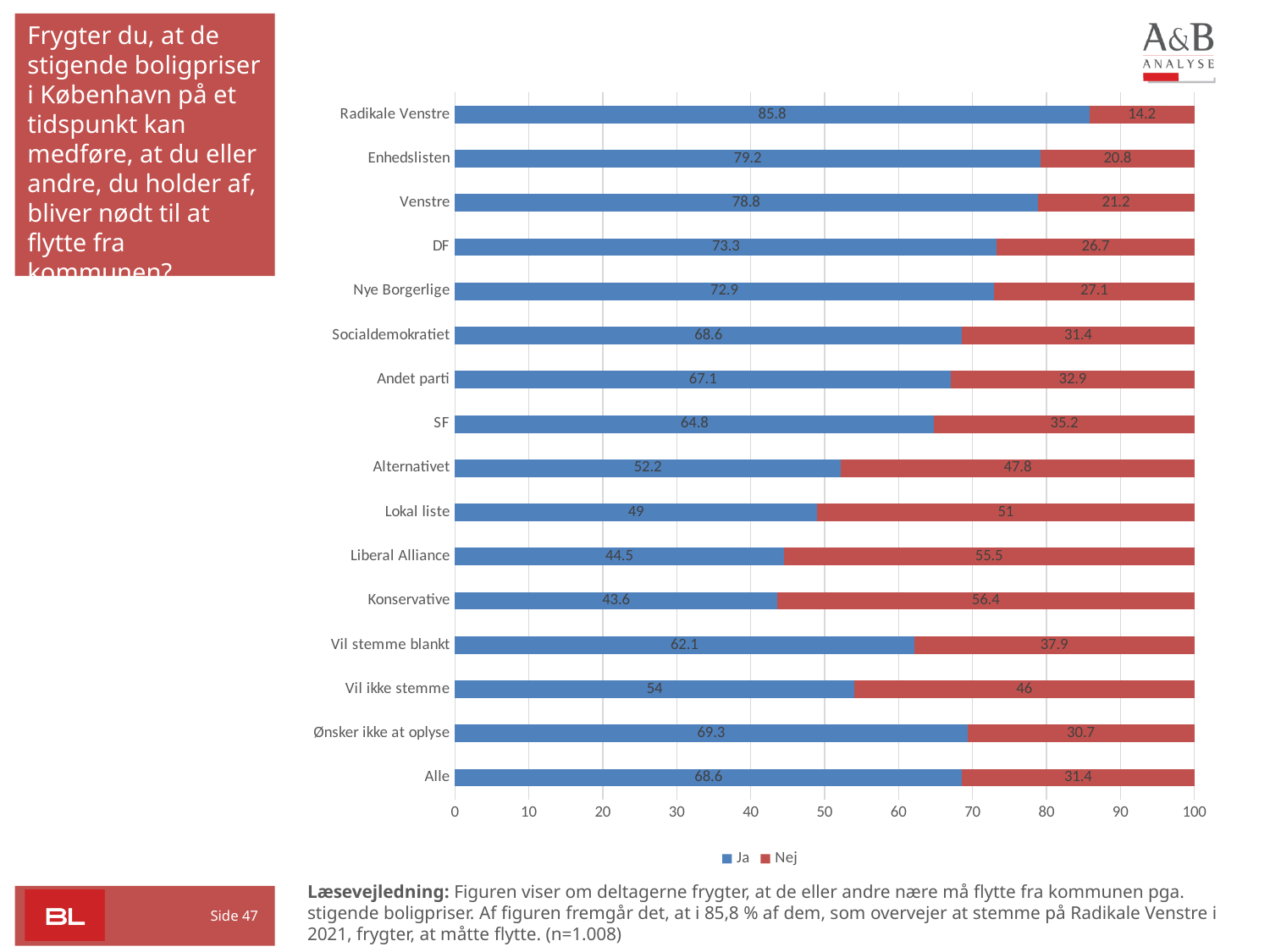
How many series does the legend list? 2 Which category has the highest "Ja" value? Radikale Venstre What is the difference between the "Ja" values for Enhedslisten and Venstre? 0.4 What kind of chart is shown on the slide? Stacked bar chart Which category has the lowest "Ja" value? Konservative What is the "Ja" value for Alle? 68.6 Which series is shown in red in the legend? Nej What is the "Nej" value for Konservative? 56.4 What is the total of the stacked bar for Vil ikke stemme? 100 Which has a larger "Nej" value, Alternativet or Lokal liste? Lokal liste What is the "Ja" value for Radikale Venstre? 85.8 How many categories are shown on the chart? 16